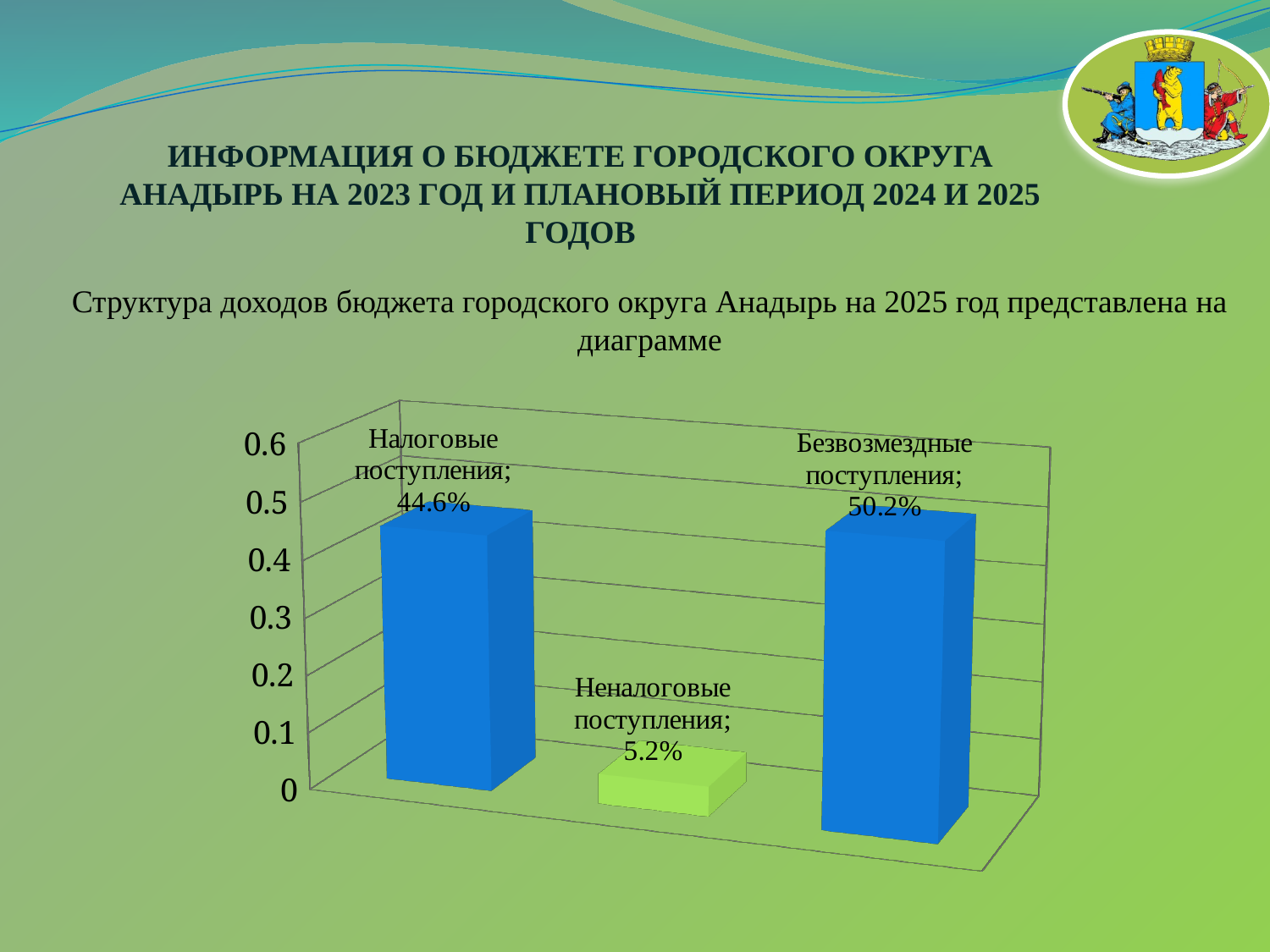
What is the value for Налоговые поступления? 44.6% What is the difference between Налоговые поступления and Неналоговые поступления? 39.4% What kind of chart is shown on the slide? bar chart Which category has the highest value? Безвозмездные поступления What is the value for Безвозмездные поступления? 50.2% What is the highest tick value shown on the vertical axis? 0.6 Is the value for Налоговые поступления greater or less than 0.5? less How many categories are shown in the chart? 3 Which category has the lowest value? Неналоговые поступления What is the value for Неналоговые поступления? 5.2% Which is larger, Налоговые поступления or Безвозмездные поступления? Безвозмездные поступления What is the difference between Безвозмездные поступления and Налоговые поступления? 5.6%